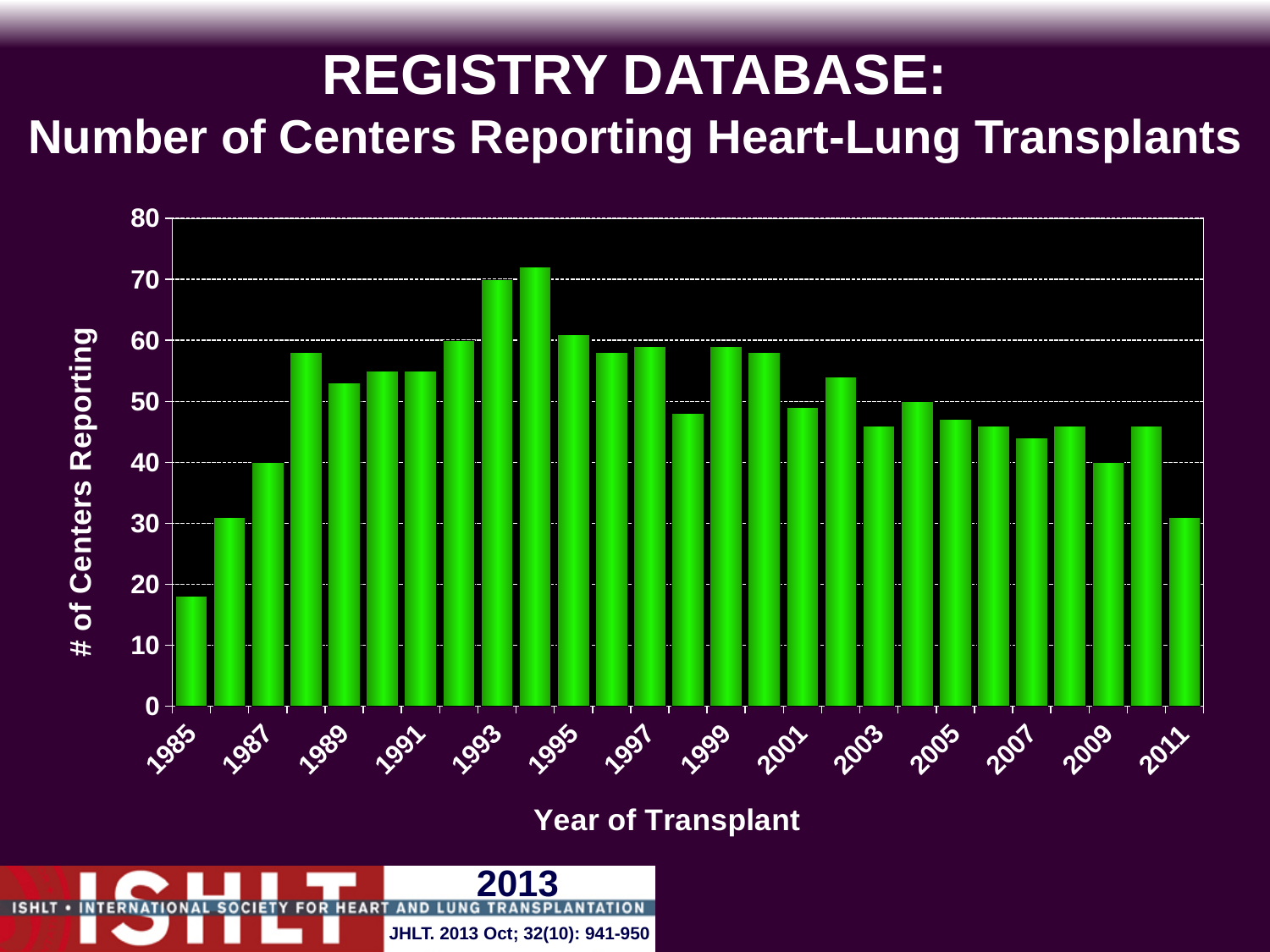
Which year has more centers reporting, 1988 or 1987? 1988 Is the number of centers reporting in 1994 greater or less than 70? greater Do the values generally rise or fall from 1985 to 1994? rise Is the number of centers reporting in 2011 greater or less than 40? less Which year has the lowest number of centers reporting? 1985 Is the number of centers reporting in 1998 greater or less than 50? less What kind of chart is shown on the slide? bar chart How many bars (years) are plotted in the chart? 27 What is the label of the x axis? Year of Transplant Which year has more centers reporting, 2005 or 2011? 2005 Which year has the highest number of centers reporting? 1994